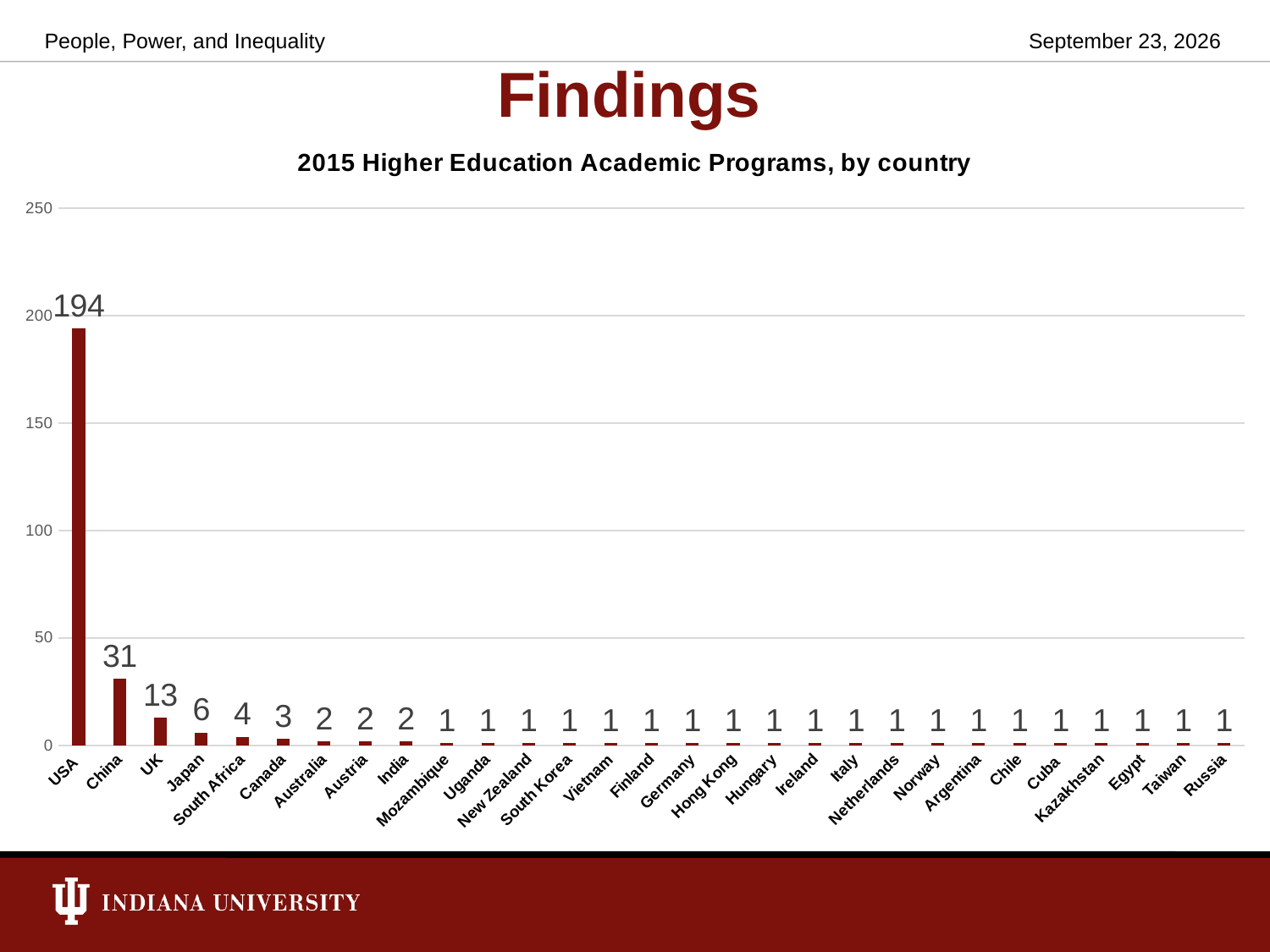
What is the difference between the values for the USA and China? 163 What is the value for Japan? 6 What kind of chart is this? bar chart Which has a larger value, South Africa or Australia? South Africa How many countries are shown on the x axis? 29 Which country has the highest value? USA What is the title of the chart? 2015 Higher Education Academic Programs, by country What is the value for the USA? 194 What is the difference between the values for the UK and Japan? 7 Is the value for the USA greater or less than 150? greater What is the value for China? 31 What is the value for Canada? 3